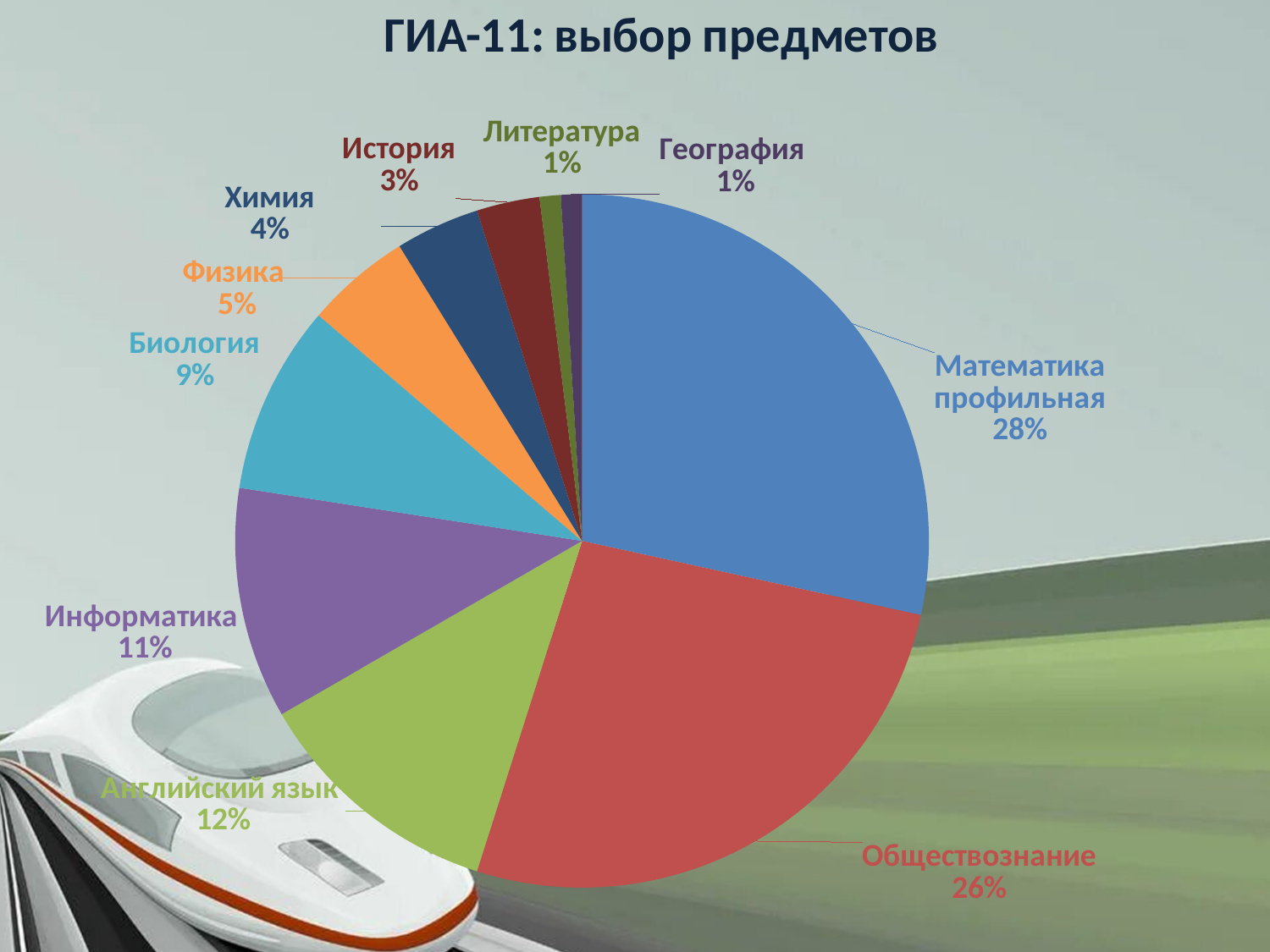
What is the title of the chart? ГИА-11: выбор предметов What is the value for Английский язык? 12% What is the difference between the values for Английский язык and История? 9% What share of the pie does Математика профильная have? 28% What is the difference between the values for Математика профильная and Обществознание? 2% What is the value for Химия? 4% Which subject has the largest slice of the pie? Математика профильная What is the value for Биология? 9% Which is larger, the value for Информатика or the value for Физика? Информатика What kind of chart is shown on the slide? pie chart How many subjects (slices) are shown in the pie chart? 10 What is the value for Обществознание? 26%